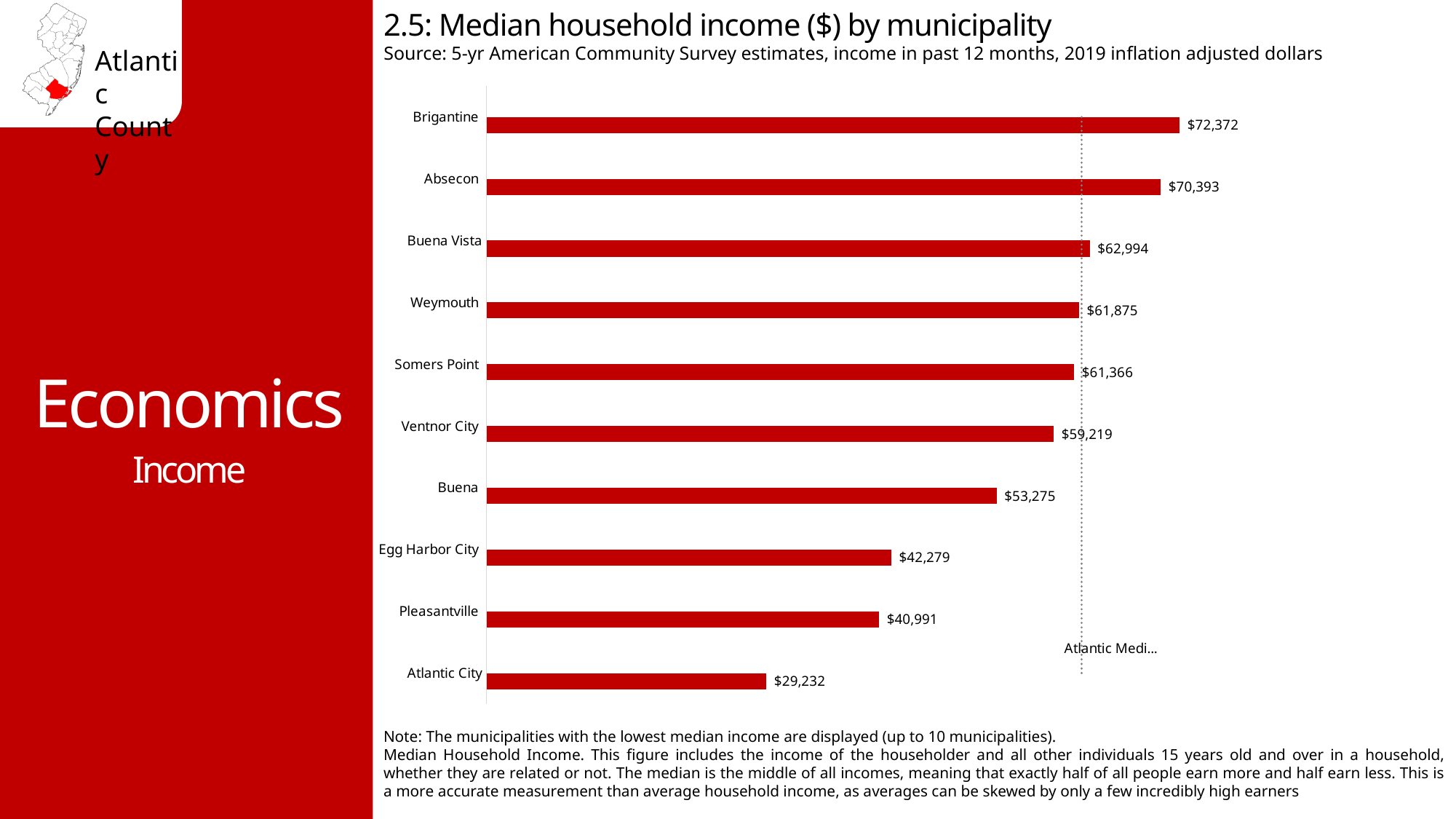
Which has a higher median household income, Ventnor City or Buena? Ventnor City What is the median household income for Brigantine? $72,372 What is the median household income for Egg Harbor City? $42,279 Which municipality has the lowest median household income shown on the chart? Atlantic City What is the title of the chart? 2.5: Median household income ($) by municipality What is the median household income for Somers Point? $61,366 Which municipality has the highest median household income shown on the chart? Brigantine What is the difference in median household income between Brigantine and Atlantic City? $43,140 How many municipalities are shown on the chart? 10 What is the difference in median household income between Egg Harbor City and Pleasantville? $1,288 What is the median household income for Atlantic City? $29,232 What type of chart is used to show median household income by municipality? Bar chart